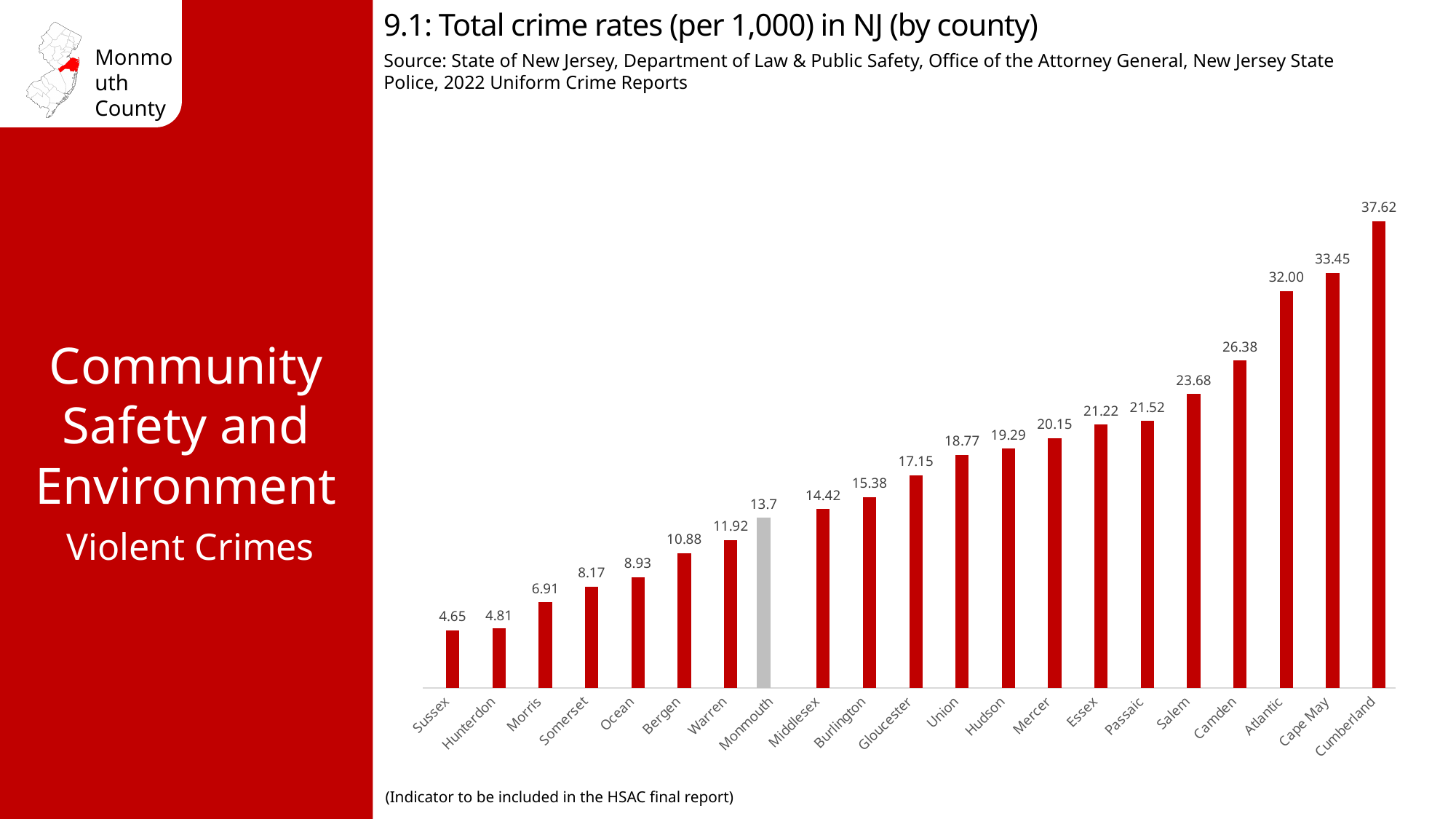
Which county has the lowest total crime rate on the chart? Sussex What is the difference between the total crime rates of Monmouth and Warren? 1.78 What is the difference between the total crime rates of Cumberland and Sussex? 32.97 Which county's bar is shown in grey rather than red? Monmouth What is the total crime rate (per 1,000) for Bergen County? 10.88 Which county has the highest total crime rate on the chart? Cumberland What kind of chart is shown on the slide? Bar chart How many counties are shown on the chart? 21 What is the total crime rate (per 1,000) for Monmouth County? 13.7 Which county has a higher total crime rate, Hudson or Union? Hudson What is the total crime rate (per 1,000) for Atlantic County? 32.00 Do the total crime rates rise or fall moving from left to right along the x axis? Rise